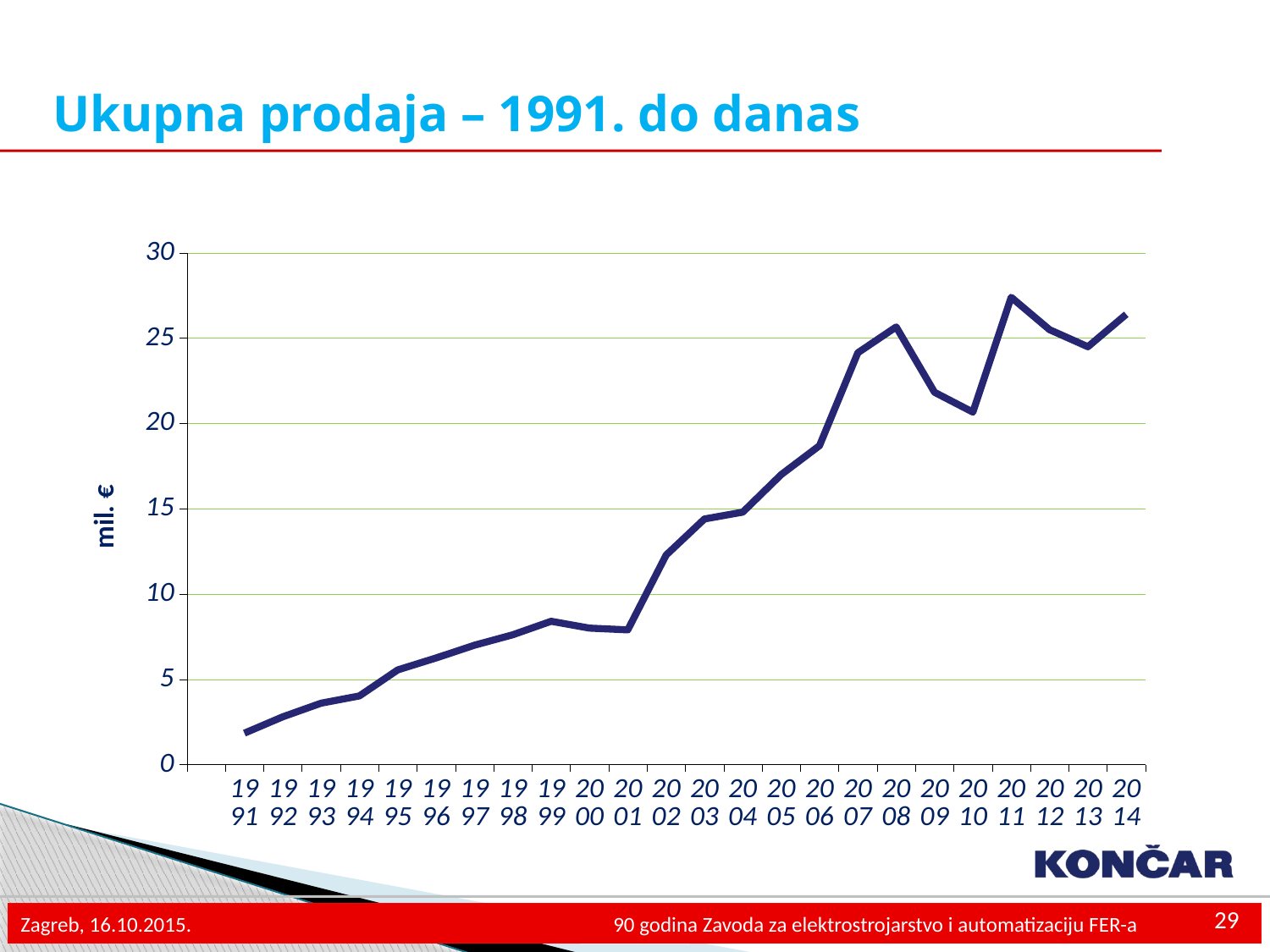
Is the value for 2001 greater or less than 10? less Which year has the lowest value on the chart? 1991 Which is larger, the value for 2002 or the value for 2001? 2002 Is the value for 2011 greater or less than 25? greater Is the value for 2007 greater or less than 20? greater What kind of chart is shown on the slide? line chart Which is larger, the value for 2011 or the value for 2008? 2011 How many years (data points) are plotted on the x axis? 24 Overall, do the values rise or fall from 1991 to 2014? rise Which year has the highest value on the chart? 2011 What is the label on the y axis of the chart? mil. €